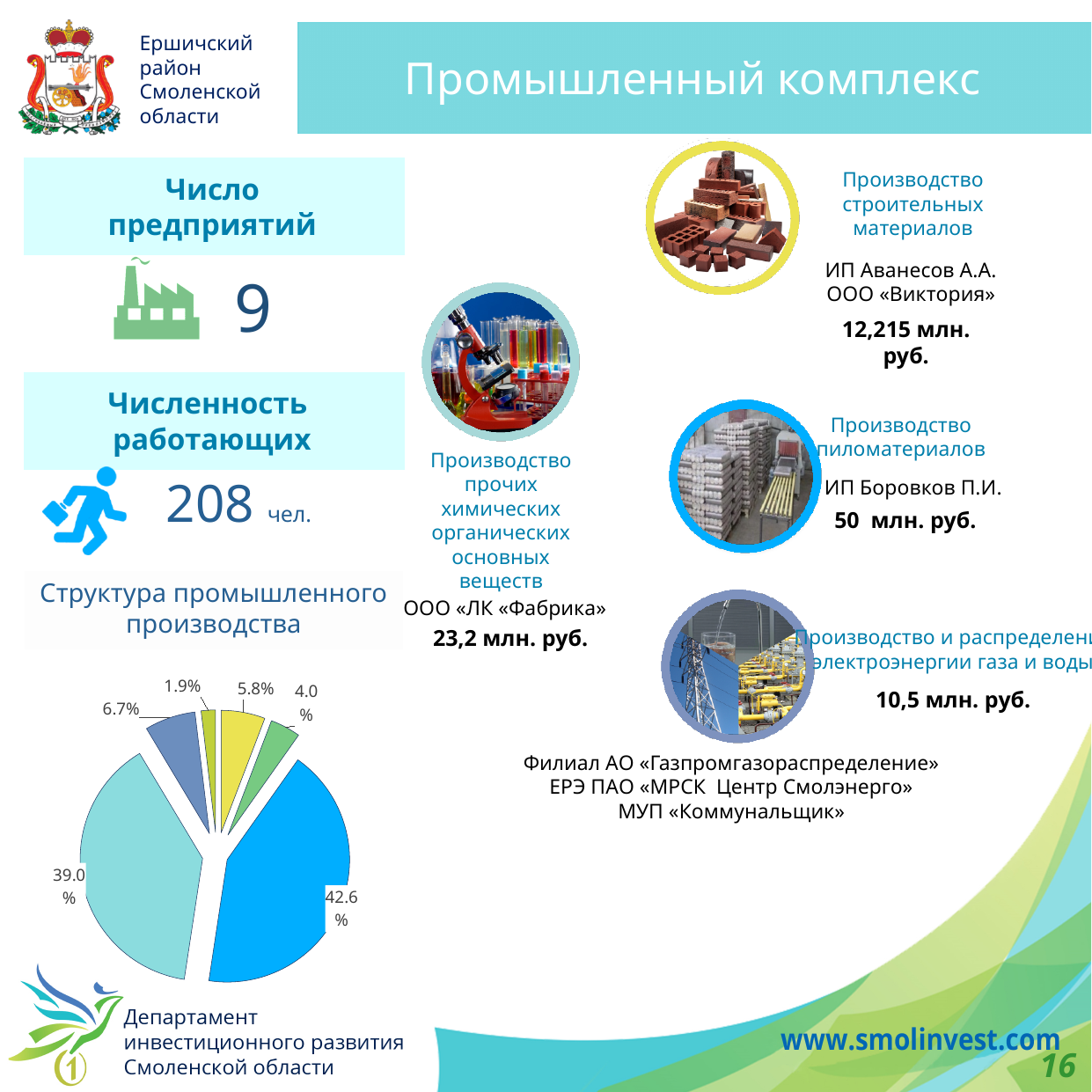
In the pie chart "Структура промышленного производства", what value is labelled on the yellow slice? 5.8% In the pie chart "Структура промышленного производства", what is the largest slice's value? 42.6% In the pie chart "Структура промышленного производства", which slice is larger: the yellow slice or the green slice? the yellow slice (5.8%) In the pie chart "Структура промышленного производства", what is the difference between the two largest slices, 42.6% and 39.0%? 3.6% In the pie chart "Структура промышленного производства", what is the smallest slice's value? 1.9% What kind of chart is shown under the heading "Структура промышленного производства"? pie chart How many slices does the pie chart "Структура промышленного производства" have? 6 In the pie chart "Структура промышленного производства", what value is labelled on the dark blue slice? 42.6% In the pie chart "Структура промышленного производства", what value is labelled on the light cyan slice? 39.0% Does the pie chart "Структура промышленного производства" have a legend? No In the pie chart "Структура промышленного производства", what value is labelled on the green slice? 4.0% In the pie chart "Структура промышленного производства", what value is labelled on the grey-blue slice? 6.7%